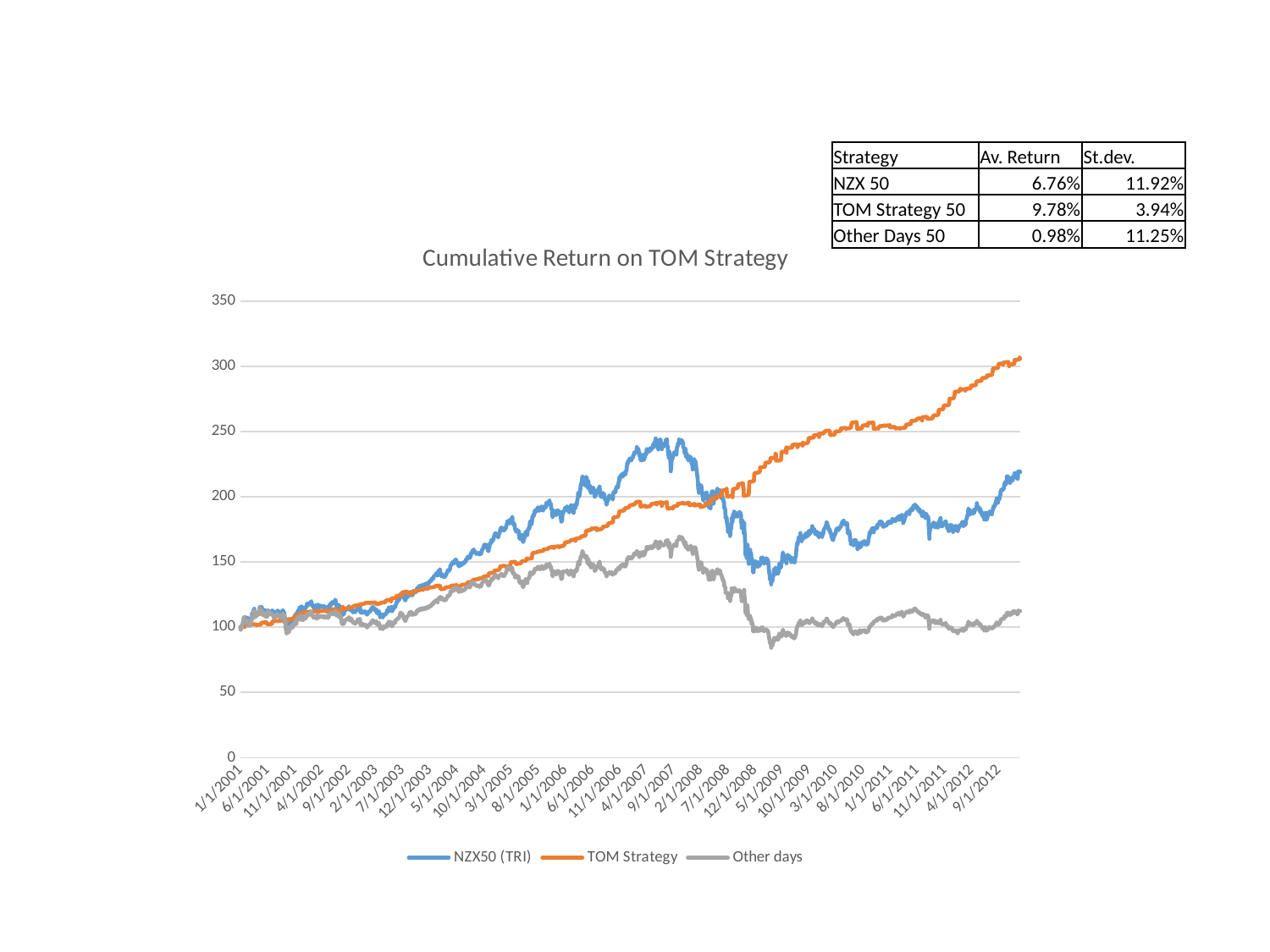
How many series does the chart's legend list? 3 At what value do all three series start on 1/1/2001? 100 Which series ends at the lowest value at the right end of the chart? Other days Is the value of TOM Strategy at the end of the chart greater or less than 250? greater What is the title of the chart? Cumulative Return on TOM Strategy What are the three series named in the chart legend? NZX50 (TRI), TOM Strategy, Other days Is the peak value of NZX50 (TRI) around 2007 greater or less than 200? greater Is the value of Other days at the end of the chart greater or less than 150? less At the end of the chart (9/1/2012), which is higher, TOM Strategy or Other days? TOM Strategy What kind of chart is shown on the slide? line chart Which series ends at the highest value at the right end of the chart? TOM Strategy Does the TOM Strategy line rise or fall overall from 1/1/2001 to 9/1/2012? rise